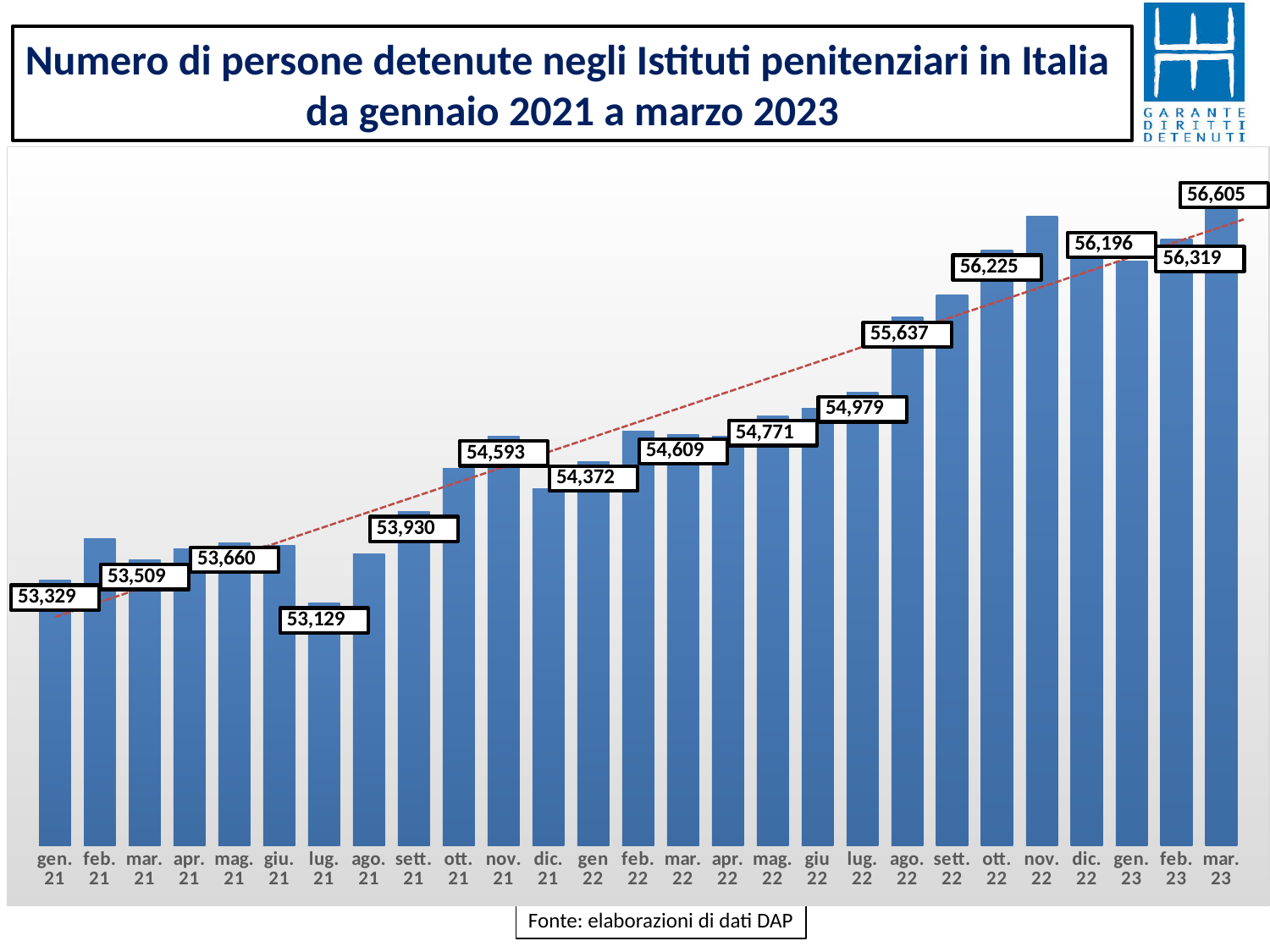
How many months (bars) are shown on the chart? 27 Which month has the lowest number of detained persons? lug. 21 What is the number of detained persons for gen. 21? 53,329 What is the number of detained persons for mar. 23? 56,605 What is the difference between the values for nov. 21 and gen 22? 221 What is the number of detained persons for sett. 21? 53,930 Do the values generally rise or fall from gen. 21 to mar. 23? rise What is the number of detained persons for ago. 22? 55,637 What kind of chart is shown on the slide? bar chart What is the number of detained persons for lug. 21? 53,129 Which is larger, the value for gen. 21 or the value for lug. 21? gen. 21 What is the difference between the values for mar. 23 and gen. 21? 3,276